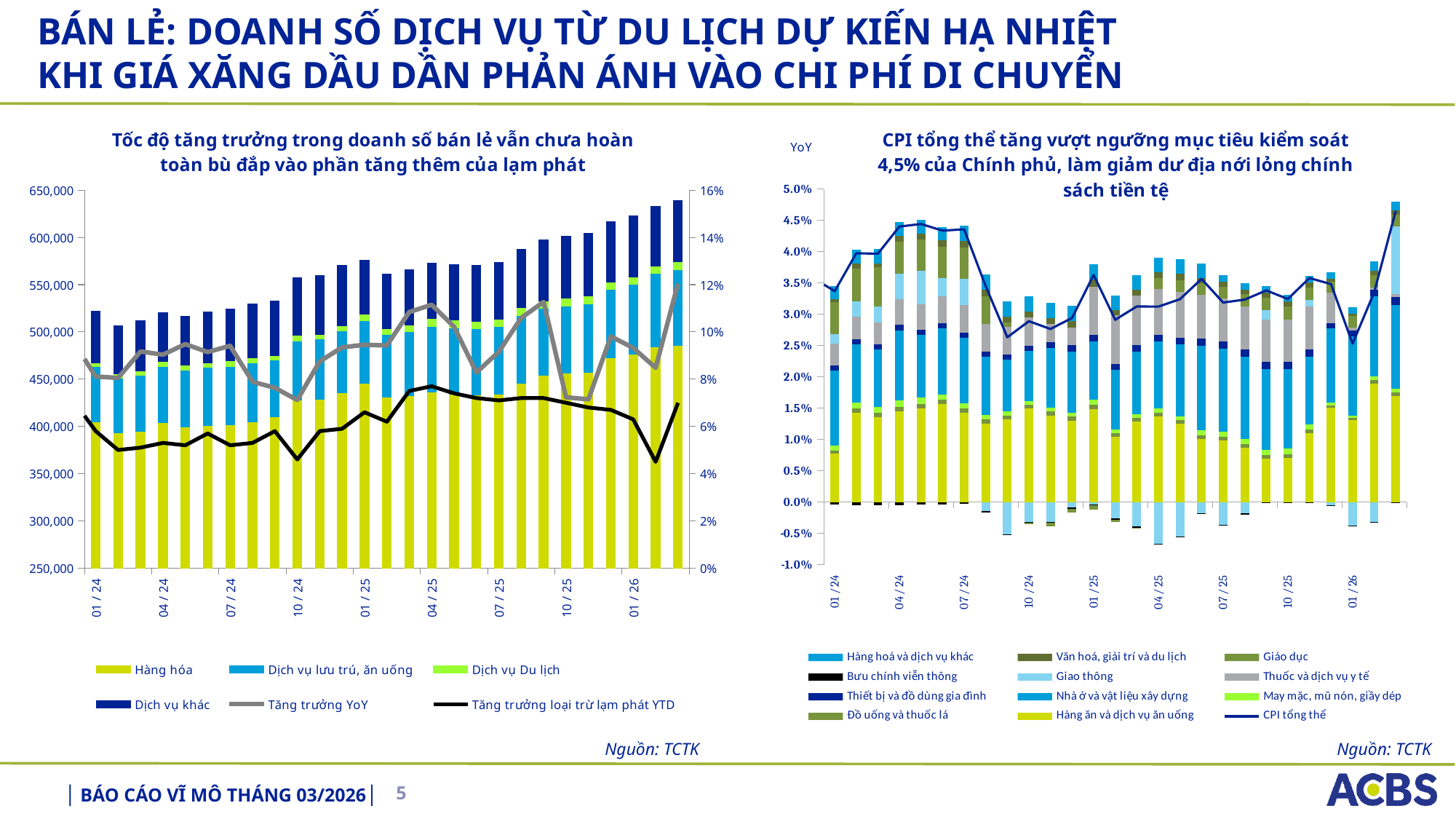
In the left chart, which series is drawn as a black line? Tăng trưởng loại trừ lạm phát YTD In the right chart, is the 'CPI tổng thể' value at 01 / 26 greater or less than 3.0%? less How many series does the legend of the left chart list? 6 In the left chart, is the 'Tăng trưởng loại trừ lạm phát YTD' value at 10 / 24 greater or less than 6%? less In the left chart, is the total of the last stacked bar (after 01 / 26) greater or less than 600,000? greater How many series does the legend of the right chart (CPI tổng thể) list? 12 What is the source cited below the right chart? Nguồn: TCTK What kind of chart is the left chart titled 'Tốc độ tăng trưởng trong doanh số bán lẻ vẫn chưa hoàn toàn bù đắp vào phần tăng thêm của lạm phát'? A stacked bar chart with line series In the right chart, does the 'CPI tổng thể' line rise or fall between 01 / 26 and the last point? rise